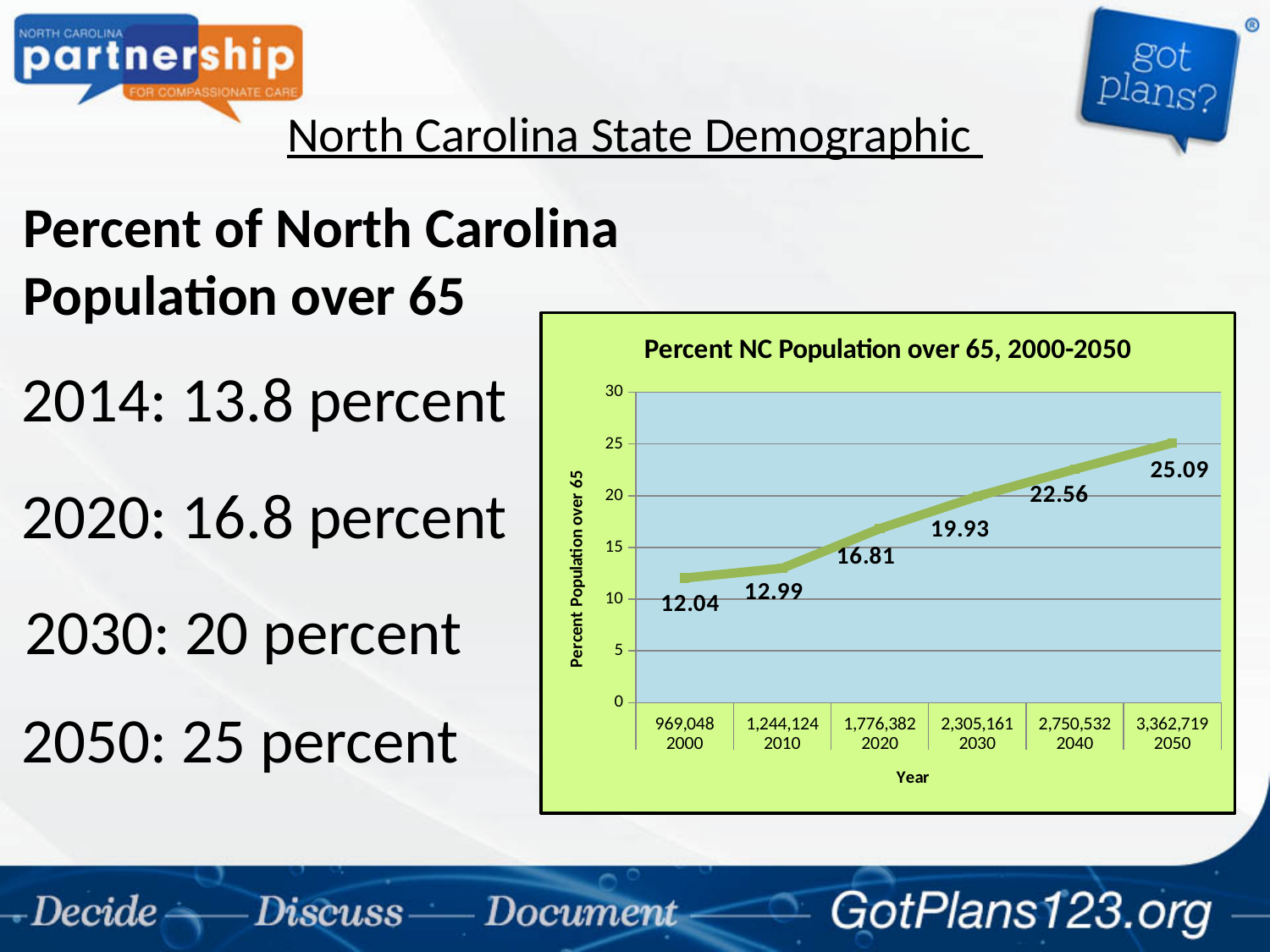
What is the percent of NC population over 65 in 2000? 12.04 What is the title of the chart? Percent NC Population over 65, 2000-2050 What is the difference between the percent values for 2050 and 2000? 13.05 How many years are plotted on the chart? 6 What is the label of the y axis? Percent Population over 65 What is the percent of NC population over 65 in 2050? 25.09 Which year has the lowest percent of NC population over 65? 2000 Which year has the highest percent of NC population over 65? 2050 What kind of chart is shown on the slide? line chart What is the percent of NC population over 65 in 2020? 16.81 Which is larger, the value for 2030 or the value for 2040? 2040 Do the values rise or fall from 2000 to 2050? rise